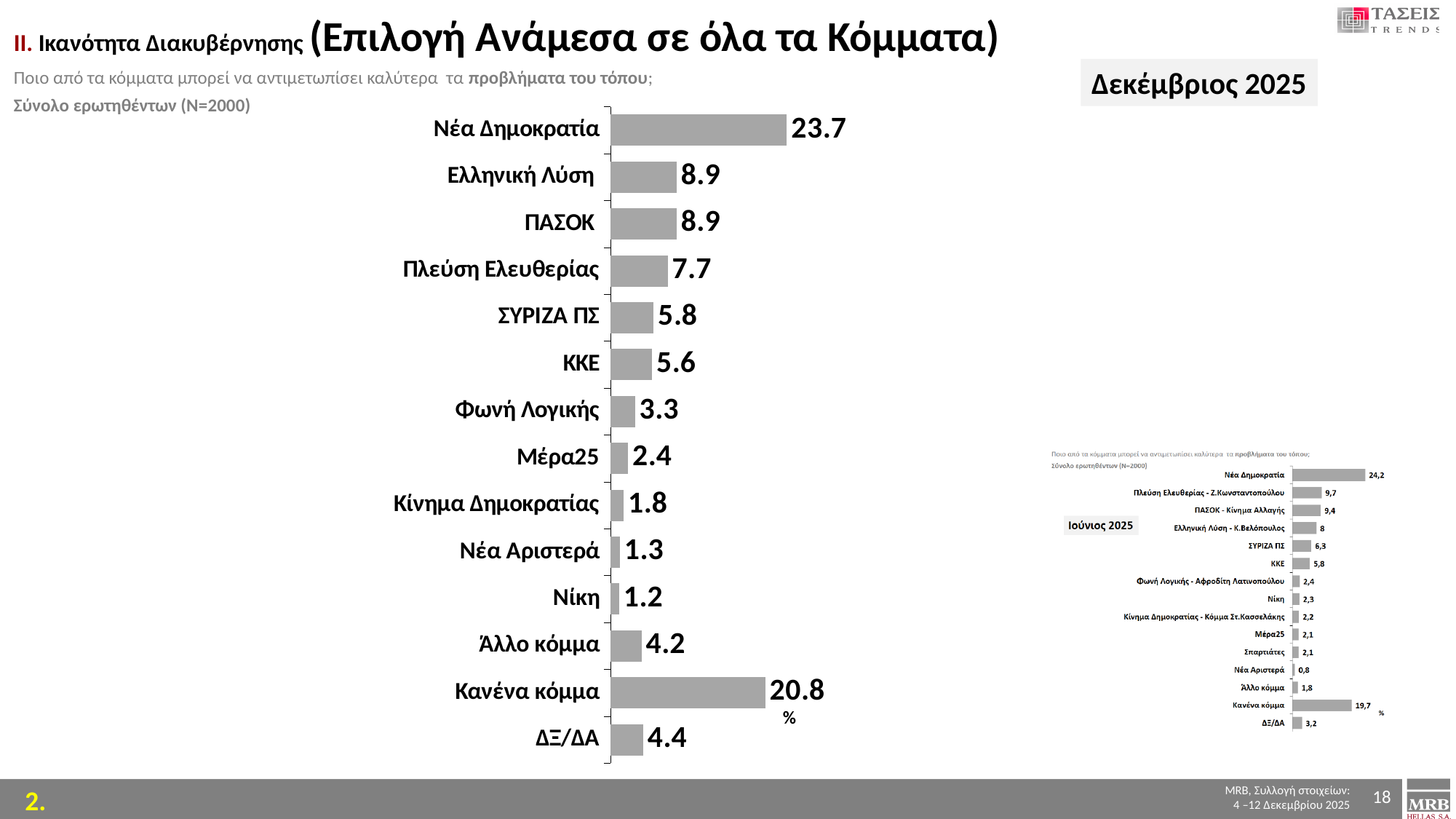
In the large December 2025 chart, which is larger, the value for Πλεύση Ελευθερίας or the value for ΣΥΡΙΖΑ ΠΣ? Πλεύση Ελευθερίας In the large December 2025 chart, what is the value for Κανένα κόμμα? 20.8 In the large December 2025 chart, what is the value for Νέα Δημοκρατία? 23.7 In the small Ιούνιος 2025 inset chart, which category has the lowest value? Νέα Αριστερά How many categories does the large December 2025 chart show? 14 In the large December 2025 chart, what is the difference between the values for Νέα Δημοκρατία and Κανένα κόμμα? 2.9 In the large December 2025 chart, what is the value for ΚΚΕ? 5.6 In the large December 2025 chart, which category has the highest value? Νέα Δημοκρατία In the large December 2025 chart, which category has the lowest value? Νίκη In the small Ιούνιος 2025 inset chart, what is the value for Κανένα κόμμα? 19,7 In the small Ιούνιος 2025 inset chart, what is the value for Νέα Δημοκρατία? 24,2 What kind of chart is the large December 2025 chart? Bar chart